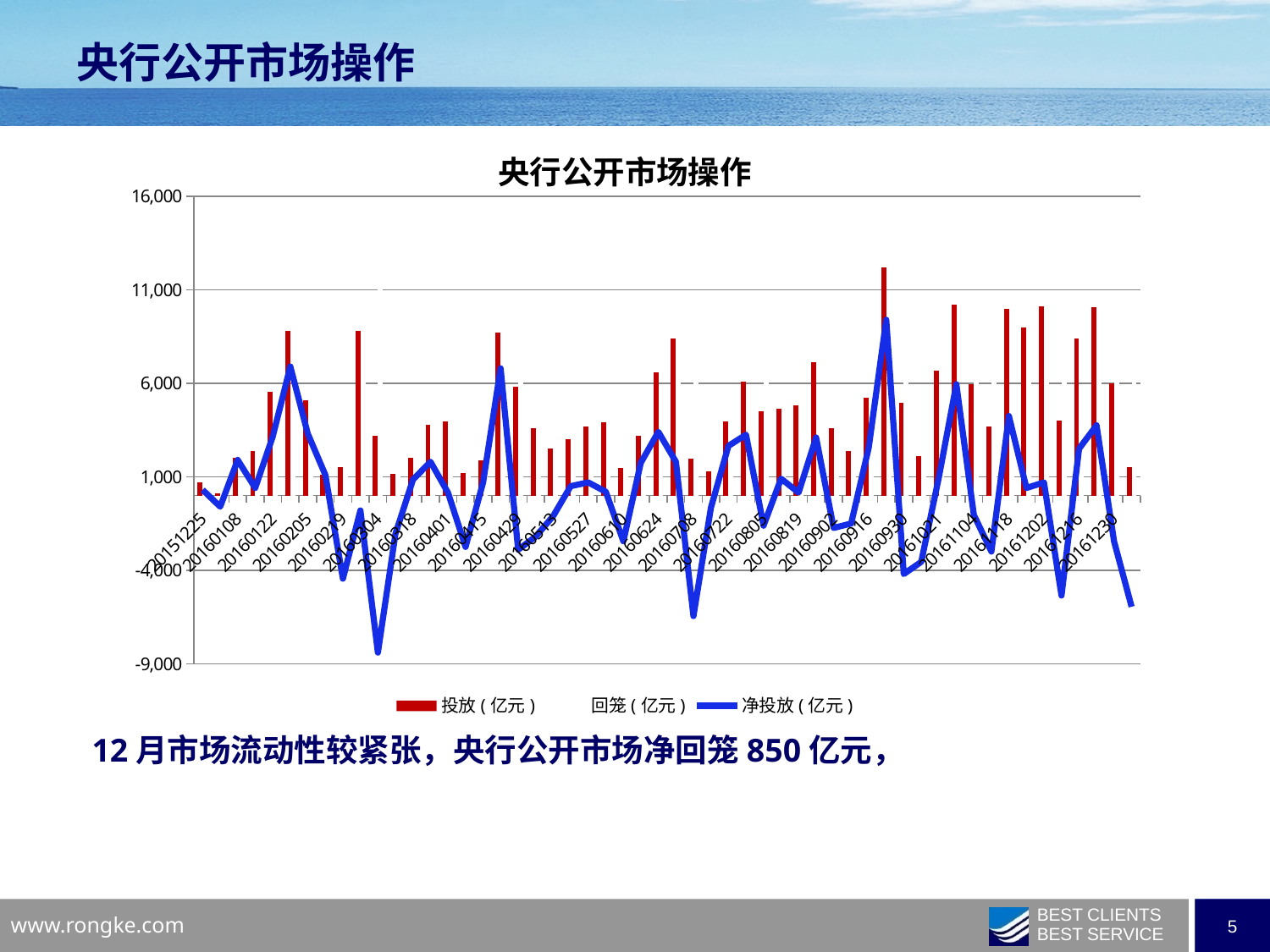
What is the highest value shown on the vertical axis? 16,000 Is the lowest point of the 净投放 line greater or less than -4,000? less Which reaches a higher value: the peak of the 投放 bars or the peak of the 净投放 line? The peak of the 投放 bars How many series does the chart legend list? 3 What kind of chart is shown on the slide? A combined bar and line chart Is the highest point of the 净投放 line greater or less than 6,000? greater Is the tallest 投放 bar greater or less than 11,000? greater What is the title of the chart? 央行公开市场操作 Does the 净投放 line rise or fall at the far right end of the chart? fall Which series is drawn as a blue line in the chart? 净投放（亿元）